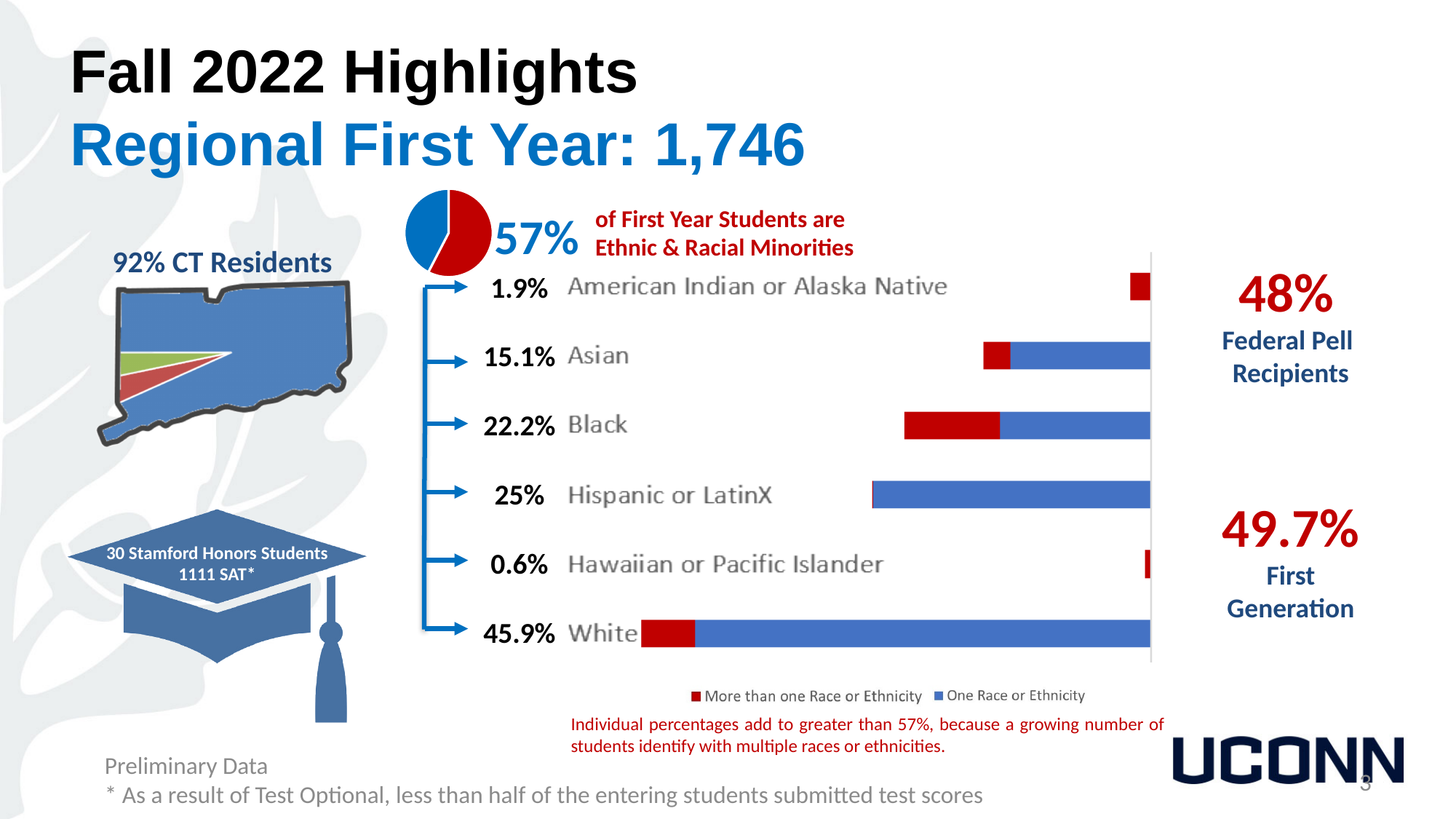
In the race and ethnicity bar chart, what percentage is shown for Asian students? 15.1% In the race and ethnicity bar chart, which category has the lowest percentage? Hawaiian or Pacific Islander How many race or ethnicity categories are shown in the bar chart? 6 In the race and ethnicity bar chart, which category has the highest percentage? White In the race and ethnicity bar chart, what percentage is shown for Black students? 22.2% In the race and ethnicity bar chart, what is the difference between the White percentage and the Hispanic or LatinX percentage? 20.9% What kind of chart is used to show the race and ethnicity breakdown? Bar chart How many series does the legend of the race and ethnicity bar chart list? 2 In the race and ethnicity bar chart, which legend entry is shown in red? More than one Race or Ethnicity In the race and ethnicity bar chart, what percentage is shown for Hispanic or LatinX students? 25% In the race and ethnicity bar chart, which is larger: the percentage for Black or the percentage for Asian? Black According to the pie chart at the top of the slide, what percentage of First Year Students are Ethnic & Racial Minorities? 57%